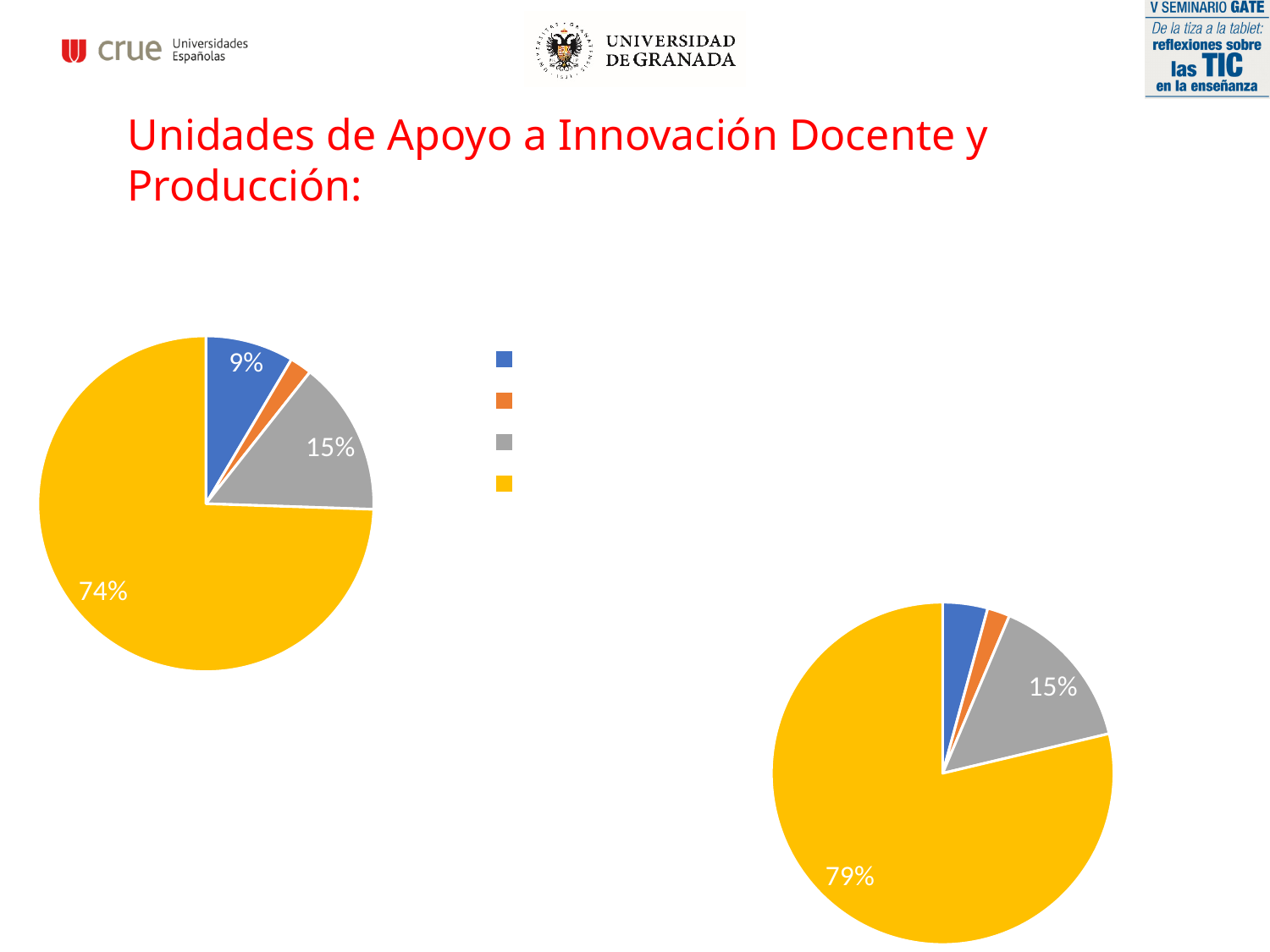
How many entries does the legend between the two pie charts list? 4 Which pie chart has the larger biggest slice, the left one or the lower-right one? the lower-right one (79%) In the left pie chart, what is the largest share shown? 74% How many slices does the left pie chart have? 4 What kind of chart is the one on the lower right of the slide? pie chart What kind of chart is the one on the left of the slide? pie chart In the left pie chart, what is the difference between the 74% slice and the 15% slice? 59 percentage points How many slices does the lower-right pie chart have? 4 In the lower-right pie chart, what is the largest share shown? 79% In the left pie chart, what colour is the largest slice? yellow In the left pie chart, what colour is the slice labelled 9%? blue